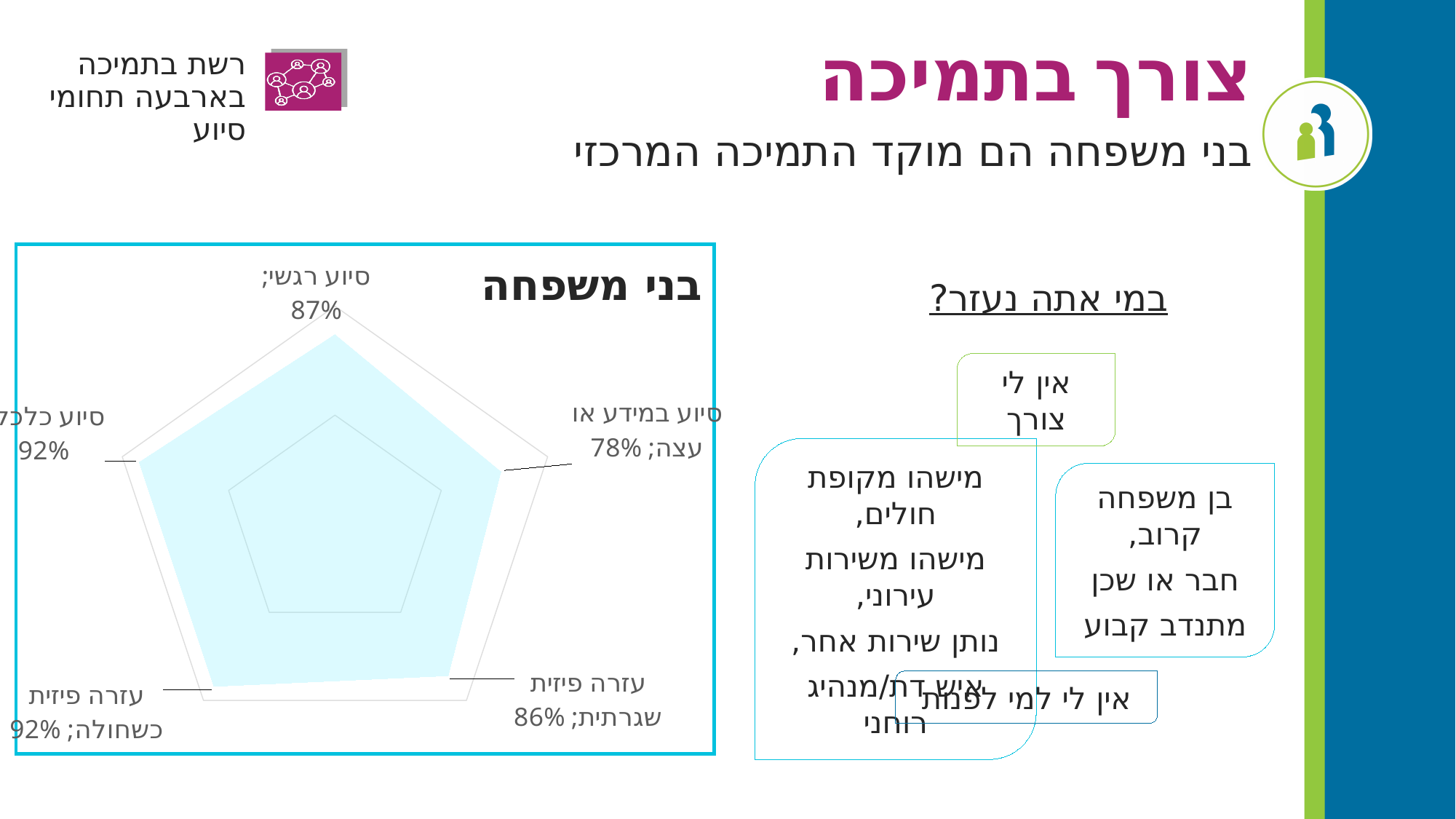
What is the value for סיוע רגשי? 87% What is the difference between the values for עזרה פיזית כשחולה and עזרה פיזית שגרתית? 6 percentage points What is the difference between the values for סיוע רגשי and סיוע במידע או עצה? 9 percentage points What type of chart is shown on the slide? Radar chart What is the value for סיוע במידע או עצה? 78% Which is larger, the value for סיוע רגשי or the value for עזרה פיזית שגרתית? סיוע רגשי Which category has the lowest value? סיוע במידע או עצה How many categories does the radar chart have? 5 What is the title of the chart? בני משפחה What is the value for עזרה פיזית כשחולה? 92% What is the value for סיוע כלכלי? 92% What is the value for עזרה פיזית שגרתית? 86%